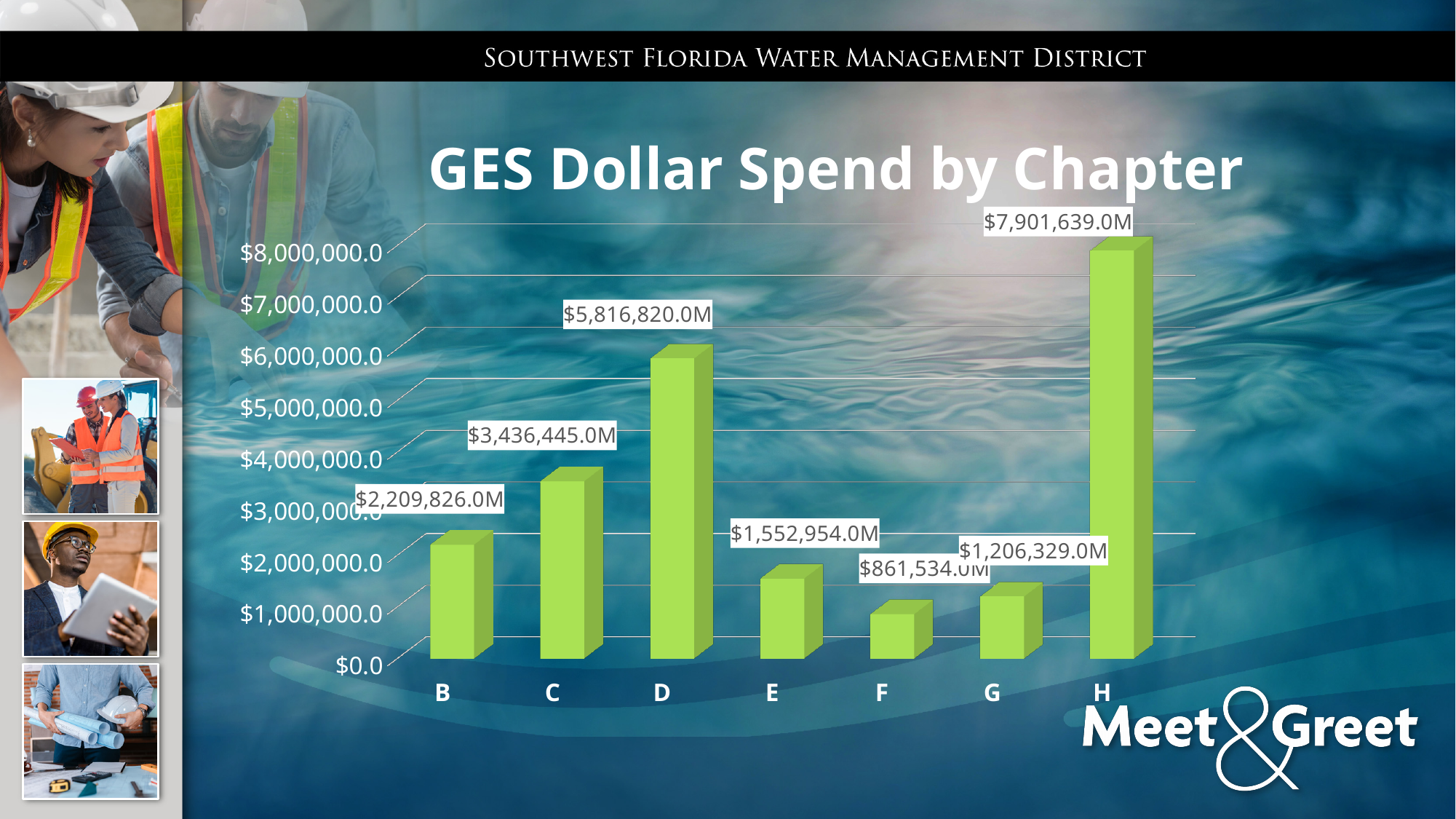
What is the difference between the values for chapter H and chapter D? $2,084,819.0M What is the value for chapter B? $2,209,826.0M Which chapter has the lowest dollar spend? F What is the value for chapter H? $7,901,639.0M Which chapter has the highest dollar spend? H What is the difference between the values for chapter C and chapter B? $1,226,619.0M Which has a larger value, chapter E or chapter G? E How many chapters are shown on the x axis? 7 What kind of chart is shown on the slide? bar chart What is the value for chapter D? $5,816,820.0M Is the value for chapter E greater or less than $2,000,000.0? less What is the value for chapter G? $1,206,329.0M